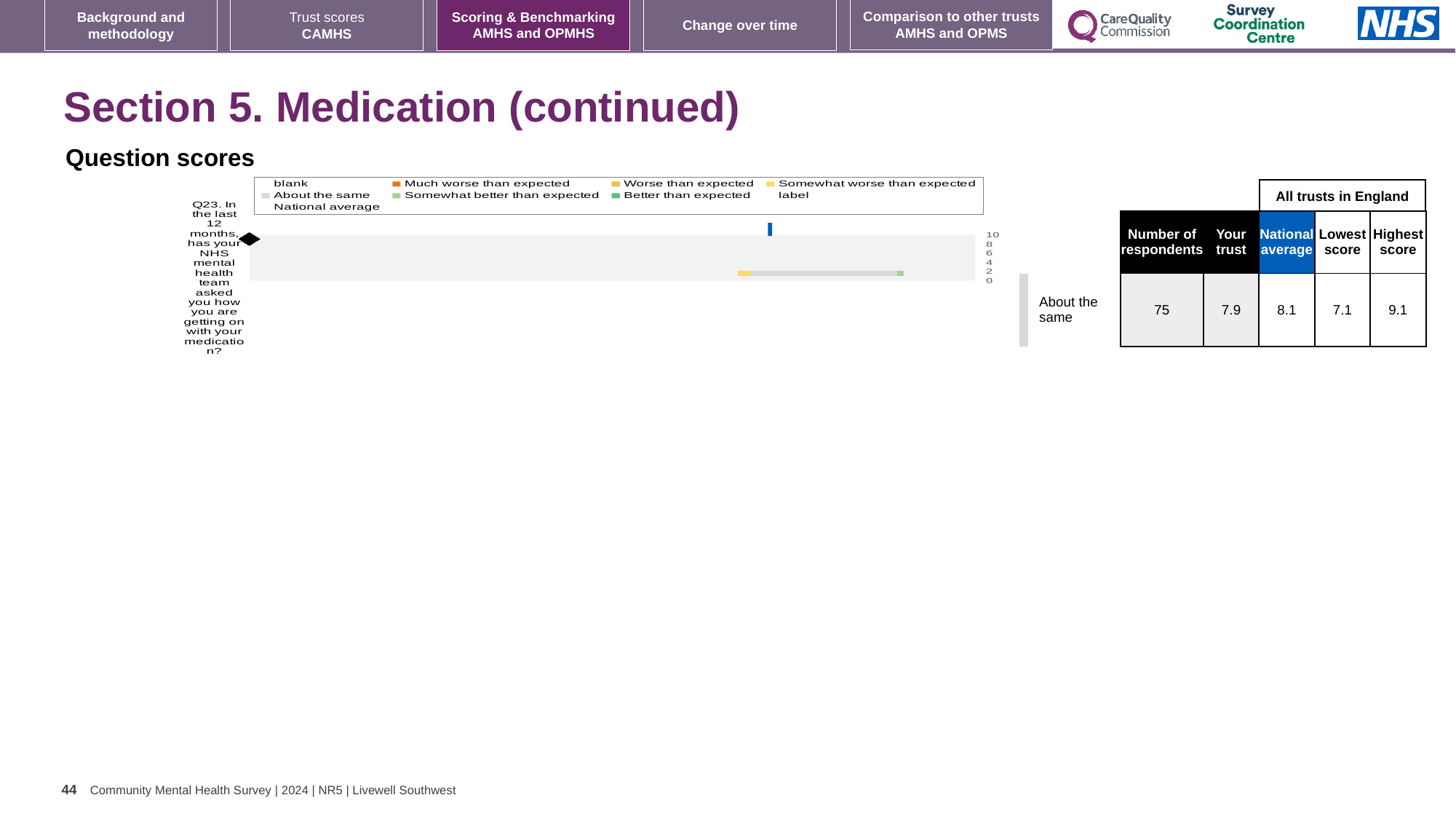
Which is larger for Q23, the 'Your trust' score or the national average? National average What is the lowest score among all trusts in England for Q23? 7.1 How many survey questions are plotted in the chart? 1 What is the 'Your trust' score for Q23 shown beside the chart? 7.9 How is the trust's Q23 result categorised relative to expectation? About the same What is the highest score among all trusts in England for Q23? 9.1 What is the difference between the highest score and the lowest score for Q23? 2.0 How many respondents answered Q23? 75 Which question number is plotted in the chart? Q23 What is the highest value shown on the chart's numeric axis? 10 What kind of chart is shown under 'Question scores'? bar chart What is the national average score for Q23 shown beside the chart? 8.1